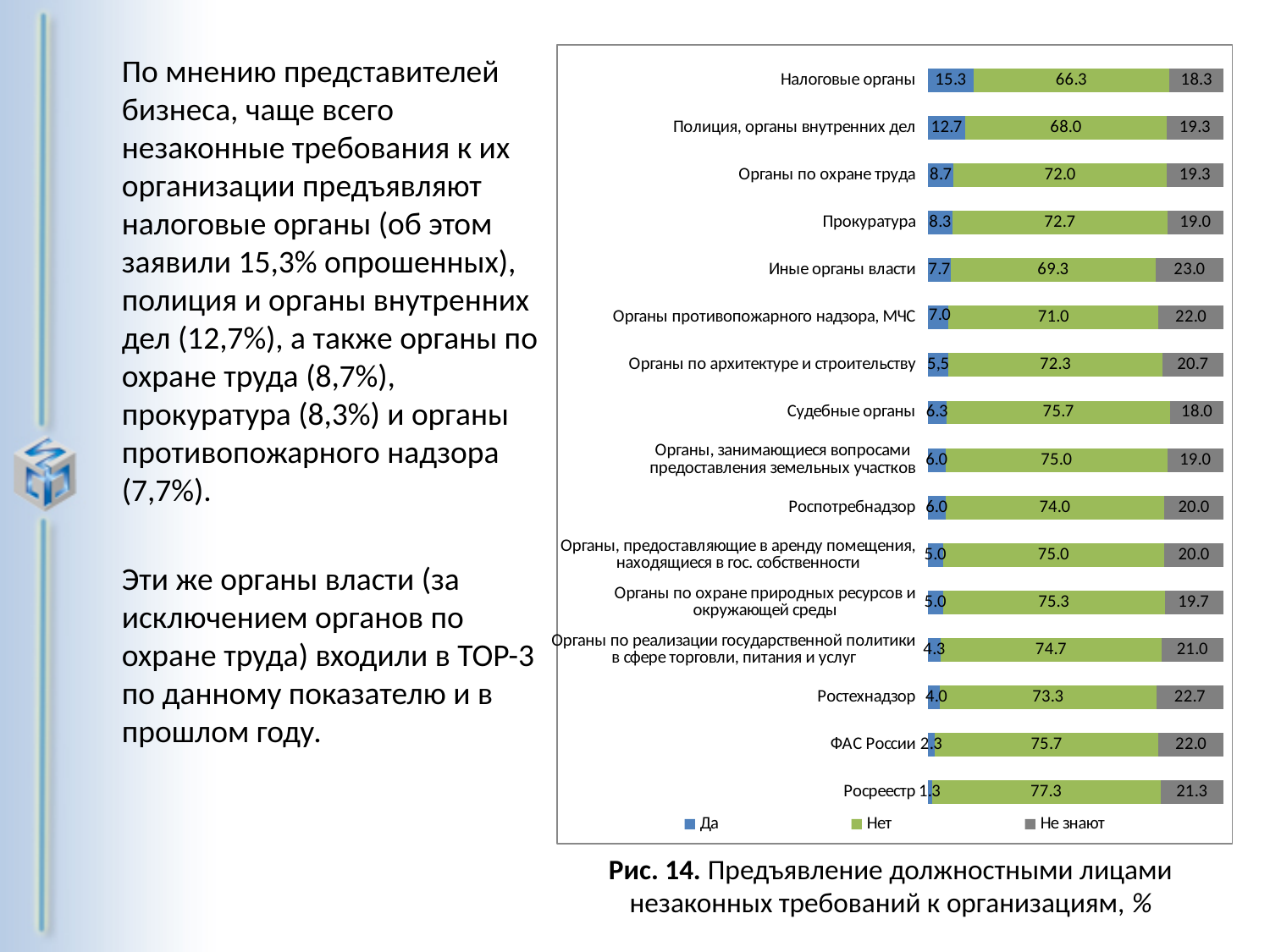
What percentage of respondents answered "Да" for Налоговые органы? 15.3 What is the difference between the "Да" values for Налоговые органы and Полиция, органы внутренних дел? 2.6 How many series does the legend list? 3 What kind of chart is shown on the slide? Stacked bar chart What is the "Нет" value for Росреестр? 77.3 What is the "Не знают" value for Ростехнадзор? 22.7 Which category has the highest "Да" value? Налоговые органы What is the total of the stacked bar for Налоговые органы? 99.9 How many categories (organs) are shown in the chart? 16 Which has a larger "Нет" value: Прокуратура or Судебные органы? Судебные органы Which category has the highest "Не знают" value? Иные органы власти Which category has the lowest "Да" value? Росреестр